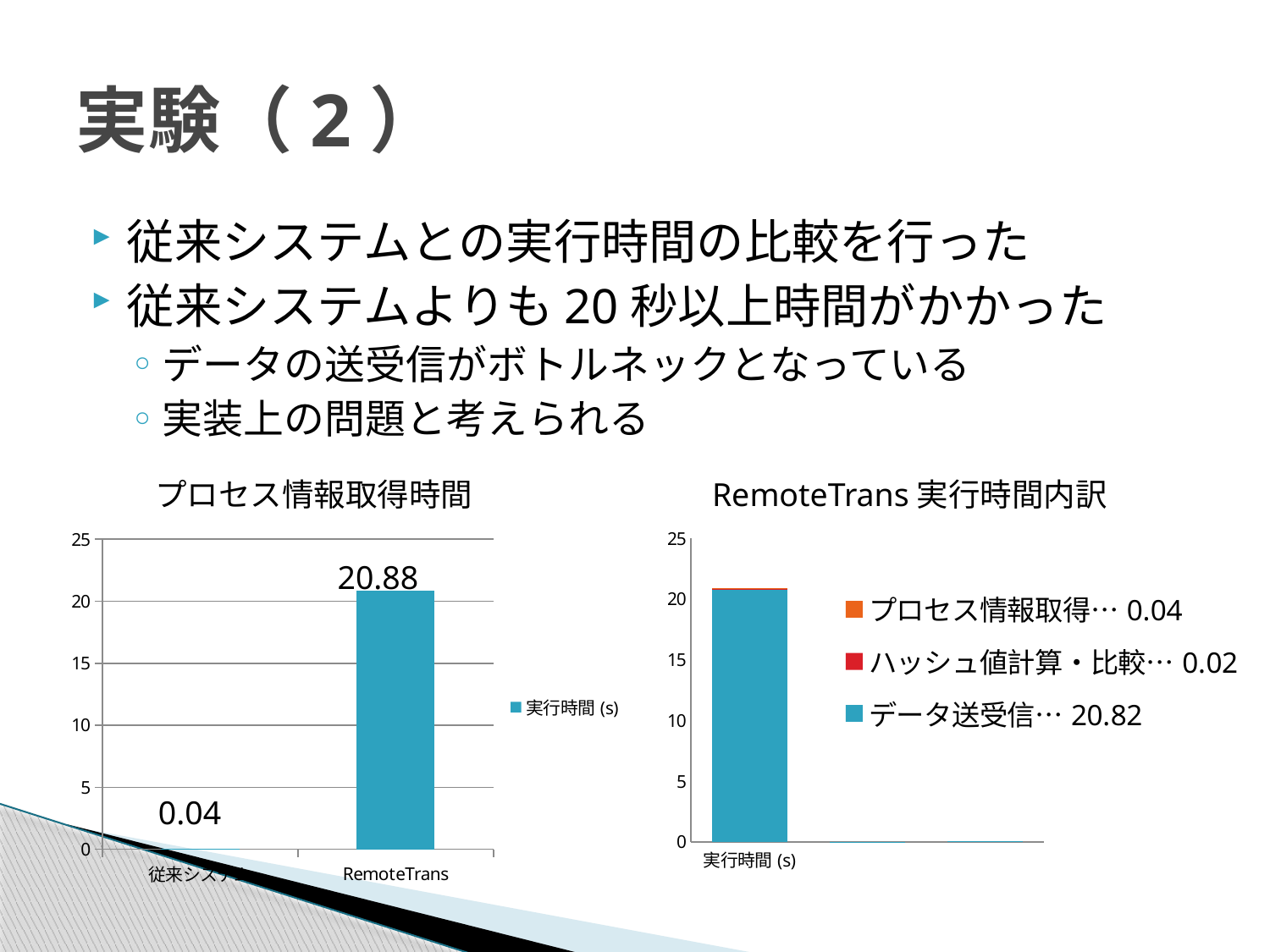
In the chart titled プロセス情報取得時間, what is the value for the left bar (従来システム)? 0.04 In the chart titled RemoteTrans 実行時間内訳, what value is given for ハッシュ値計算・比較? 0.02 In the chart titled RemoteTrans 実行時間内訳, which series is larger: プロセス情報取得 or データ送受信? データ送受信 In the chart titled プロセス情報取得時間, which category has the highest value? RemoteTrans In the chart titled プロセス情報取得時間, how many categories are shown on the x axis? 2 In the chart titled プロセス情報取得時間, is the value for RemoteTrans greater or less than 20? greater What kind of chart is the chart titled RemoteTrans 実行時間内訳? stacked bar chart In the chart titled プロセス情報取得時間, what is the legend entry? 実行時間 (s) In the chart titled RemoteTrans 実行時間内訳, how many series does the legend list? 3 In the chart titled プロセス情報取得時間, what is the value for RemoteTrans? 20.88 In the chart titled RemoteTrans 実行時間内訳, what value is given for データ送受信? 20.82 In the chart titled プロセス情報取得時間, what is the difference between the RemoteTrans value and the 従来システム value? 20.84